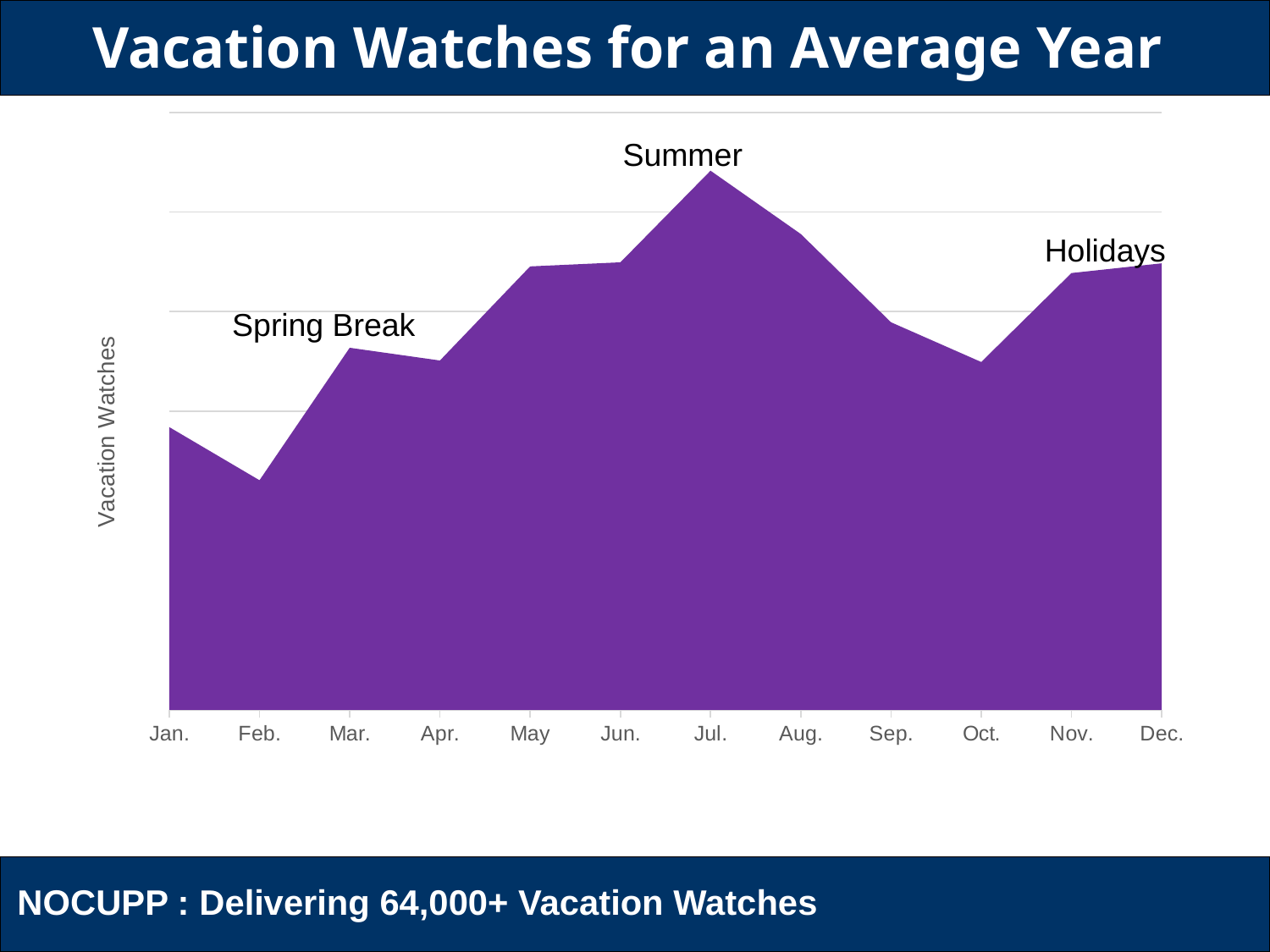
Which month has the lowest number of vacation watches? Feb. Which month has the highest number of vacation watches? Jul. Do vacation watches rise or fall from Jul. to Oct.? Fall Which month has more vacation watches, Jan. or Feb.? Jan. What label is shown on the y axis? Vacation Watches Do vacation watches rise or fall from Feb. to Jul.? Rise Which month has more vacation watches, Sep. or Oct.? Sep. How many months are plotted along the x axis? 12 Which annotation is placed above the peak in Jul.? Summer What kind of chart is shown on the slide? Area chart Which month has more vacation watches, Aug. or Sep.? Aug.